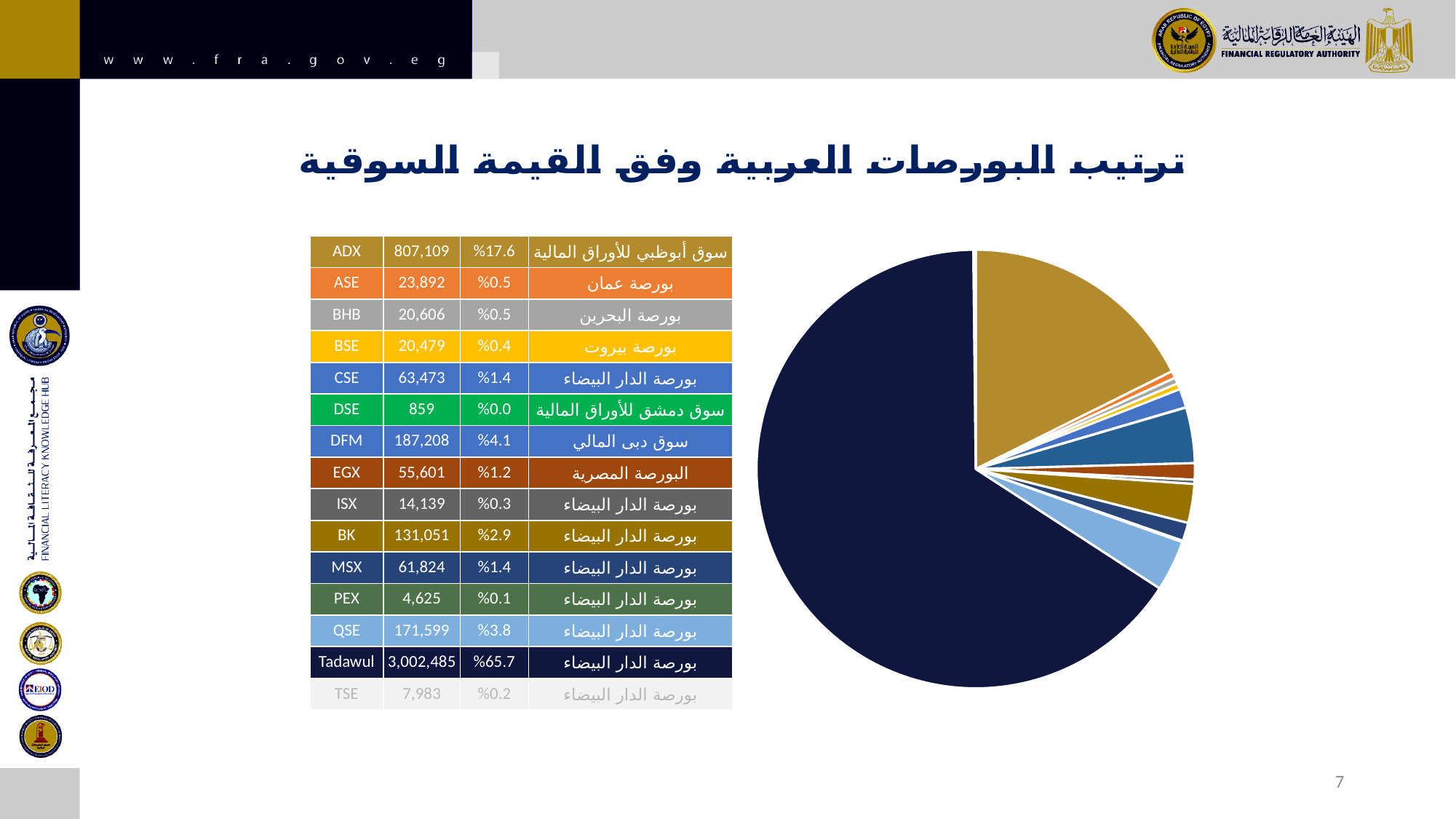
What colour is the largest slice of the pie chart? dark navy blue What is the difference in market value between DFM and QSE? 15,609 Which exchange has the largest share of the pie? Tadawul Which exchange has the smallest market value in the table? DSE What share of the pie does Tadawul hold? %65.7 How many exchanges are listed in the table accompanying the pie chart? 15 What is the difference in market value between ASE and BHB? 3,286 What kind of chart is shown on the slide? pie chart Which has the larger market value, ADX or DFM? ADX What share of the pie does ADX hold? %17.6 What is the market value listed for ADX? 807,109 What is the market value listed for QSE? 171,599